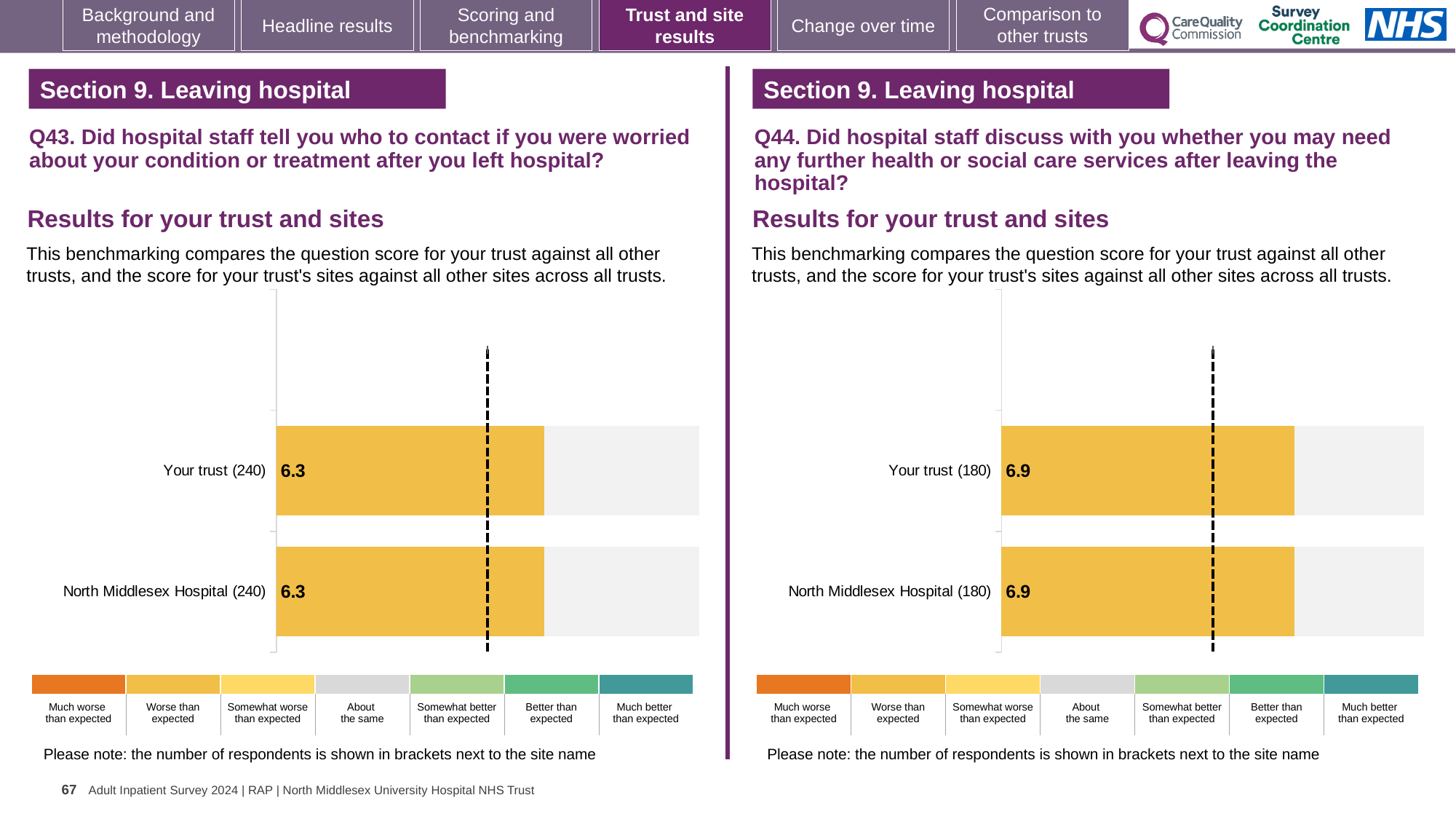
In the Q43 chart on the left, what is the score for Your trust? 6.3 In the Q44 chart on the right, how many respondents are shown in brackets next to North Middlesex Hospital? 180 In the Q43 chart on the left, what is the difference between the score for Your trust and the score for North Middlesex Hospital? 0 How many bars are plotted in the Q43 chart on the left? 2 What kind of chart is the Q44 chart on the right? Bar chart In the Q44 chart on the right, what is the difference between the score for Your trust and the score for North Middlesex Hospital? 0 In the Q44 chart on the right, what is the score for Your trust? 6.9 In the Q43 chart on the left, how many respondents are shown in brackets next to Your trust? 240 How many bars are plotted in the Q44 chart on the right? 2 In the Q43 chart on the left, what is the score for North Middlesex Hospital? 6.3 In the Q44 chart on the right, what is the score for North Middlesex Hospital? 6.9 Is the score for Your trust in the Q44 chart on the right larger or smaller than the score for Your trust in the Q43 chart on the left? Larger